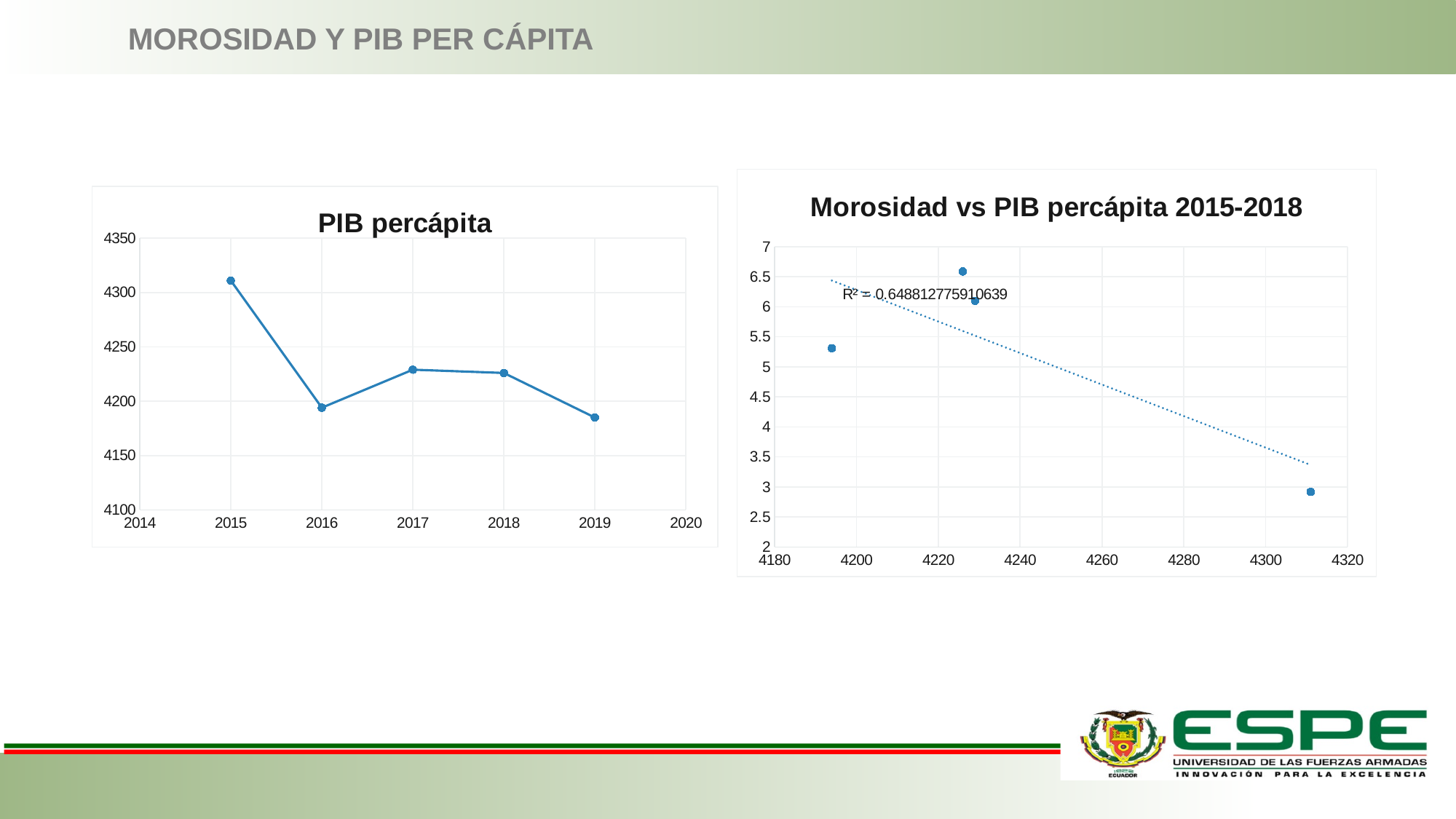
In the "PIB percápita" chart, is the value for 2015 greater or less than 4300? greater In the "PIB percápita" chart, is the value for 2017 greater or less than 4200? greater In the "PIB percápita" chart, does the value rise or fall from 2015 to 2016? fall In the "PIB percápita" chart, which is larger, the value for 2015 or the value for 2016? 2015 What kind of chart is the "PIB percápita" chart on the left? line chart In the "PIB percápita" chart, which year has the highest value? 2015 In the "Morosidad vs PIB percápita 2015-2018" chart, what R² value is shown for the trendline? R² = 0.648812775910639 In the "Morosidad vs PIB percápita 2015-2018" chart, is the value of the point at about 4310 on the x axis greater or less than 3? less What kind of chart is the "Morosidad vs PIB percápita 2015-2018" chart on the right? scatter chart In the "PIB percápita" chart, how many data points are plotted? 5 In the "Morosidad vs PIB percápita 2015-2018" chart, how many data points are plotted? 4